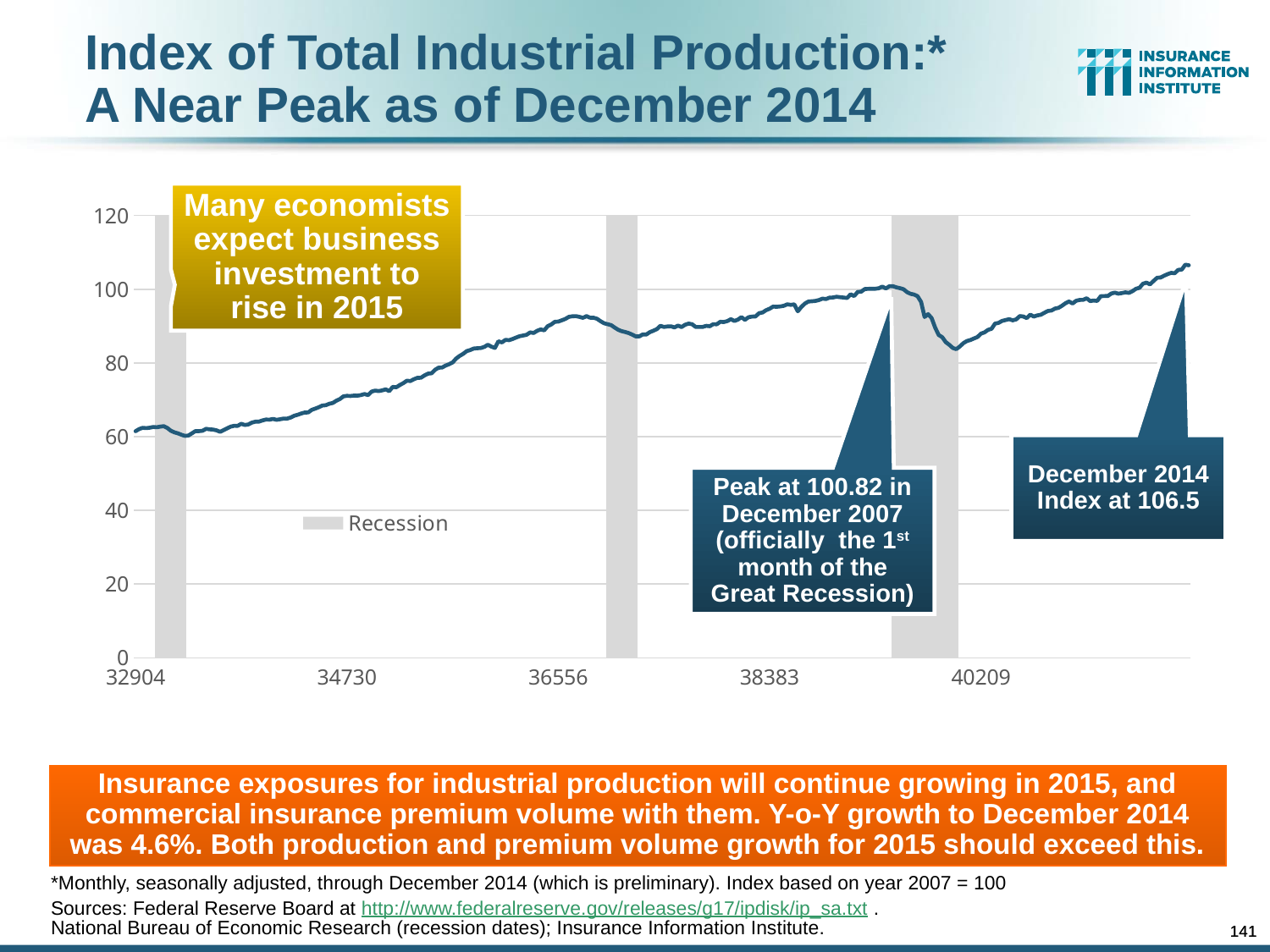
What was the peak value of the index in December 2007, according to the callout? 100.82 Is the value of the index at the left end of the line greater or less than 80? less By how much does the December 2014 index value exceed the December 2007 peak? 5.68 What does the gray shaded area in the legend represent? Recession Which is larger: the December 2007 peak or the December 2014 index value? December 2014 index value What kind of chart is shown on the slide? line chart How many shaded recession periods are marked on the chart? 3 What is the value of the Index of Total Industrial Production in December 2014, according to the callout? 106.5 What is the highest value shown on the vertical axis of the chart? 120 Is the value of the index at the right end of the line greater or less than 100? greater Does the index generally rise or fall from the left end of the chart to the right end? rise